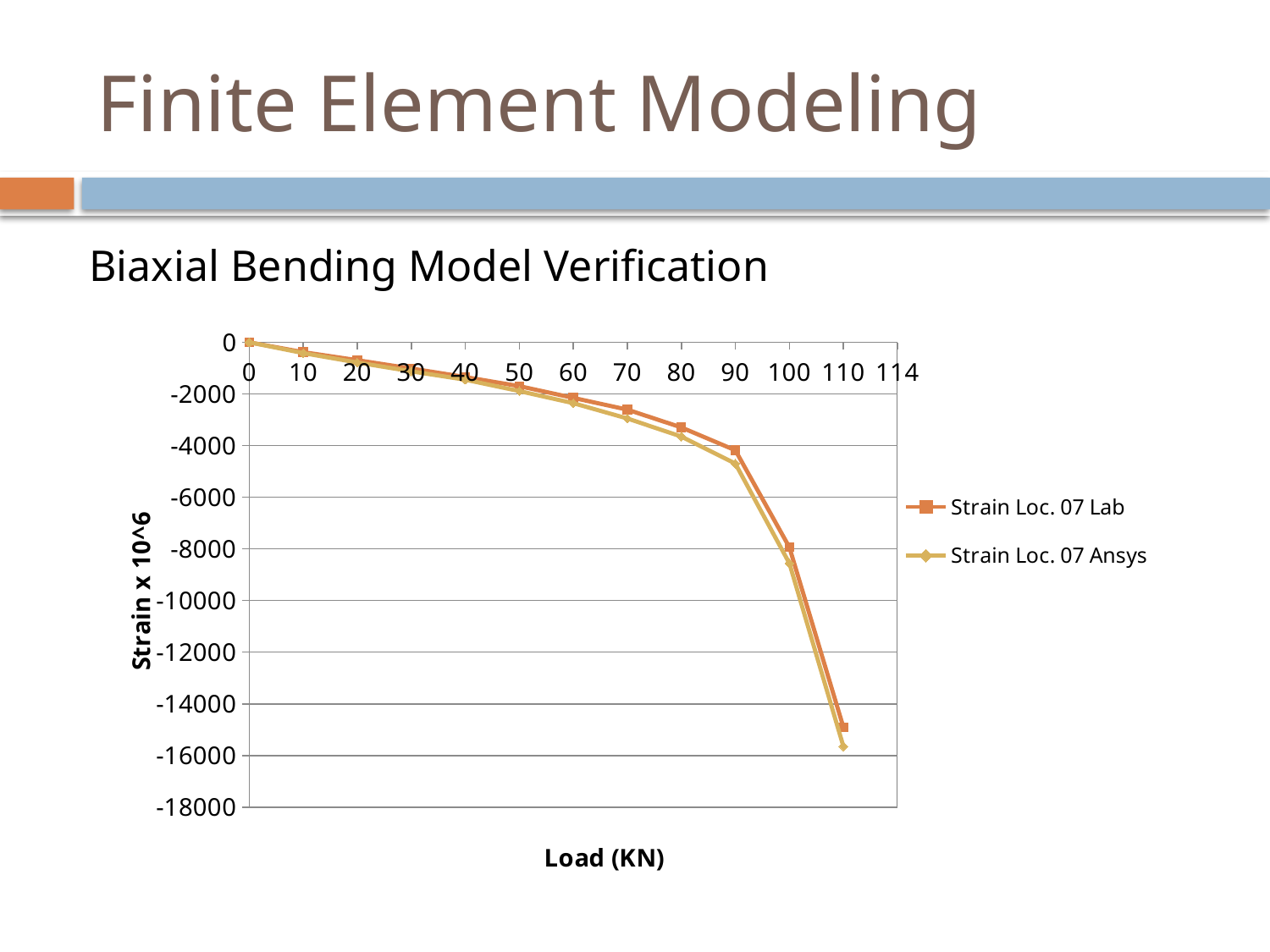
Is the value for Strain Loc. 07 Ansys at a load of 100 KN greater or less than -8000? less Is the value for Strain Loc. 07 Lab at a load of 80 KN greater or less than -4000? greater At a load of 110 KN, which series has the more negative strain value, Strain Loc. 07 Lab or Strain Loc. 07 Ansys? Strain Loc. 07 Ansys What are the two series named in the legend? Strain Loc. 07 Lab and Strain Loc. 07 Ansys Is the value for Strain Loc. 07 Lab at a load of 110 KN greater or less than -14000? less At which load does the Strain Loc. 07 Ansys series reach its lowest (most negative) strain value? 110 Do the strain values rise or fall as the load increases along the x axis? fall What is the strain value for Strain Loc. 07 Lab at a load of 0 KN? 0 How many series does the legend list? 2 How many data points are plotted for the Strain Loc. 07 Lab series? 12 What kind of chart is shown on the slide? line chart What is the title of the x axis? Load (KN)